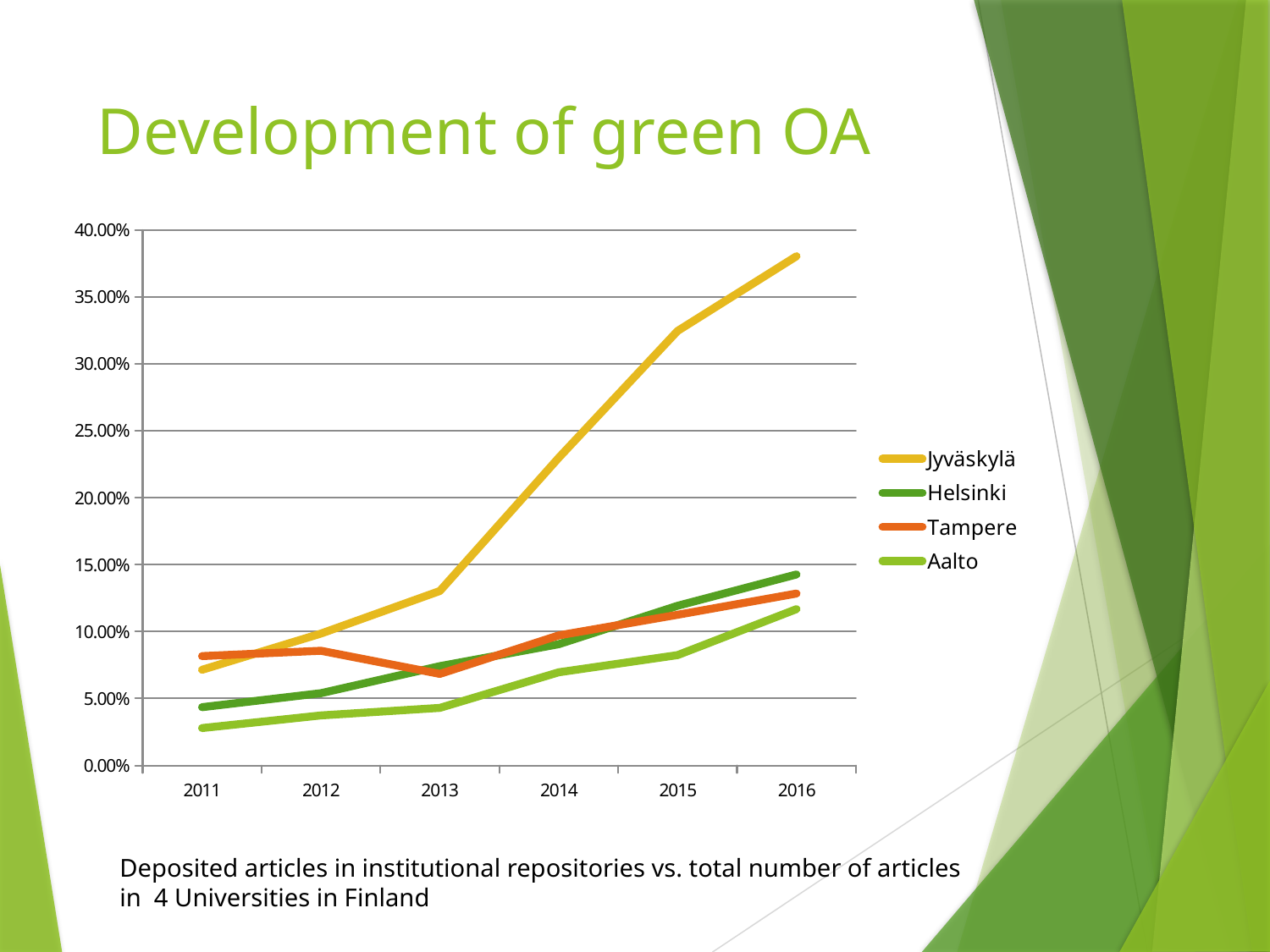
Is the value for Jyväskylä in 2015 greater or less than 30.00%? greater Does the Jyväskylä line rise or fall from 2011 to 2016? rise Which university has the lowest value in 2011? Aalto What is the title of the slide? Development of green OA What kind of chart is shown on the slide? line chart How many series does the legend list? 4 In 2011, which is larger: the value for Tampere or the value for Helsinki? Tampere Is the value for Aalto in 2011 greater or less than 5.00%? less Is the value for Jyväskylä in 2016 greater or less than 35.00%? greater Which university has the highest value in 2016? Jyväskylä Which university has the lowest value in 2016? Aalto How many years are shown on the x axis? 6